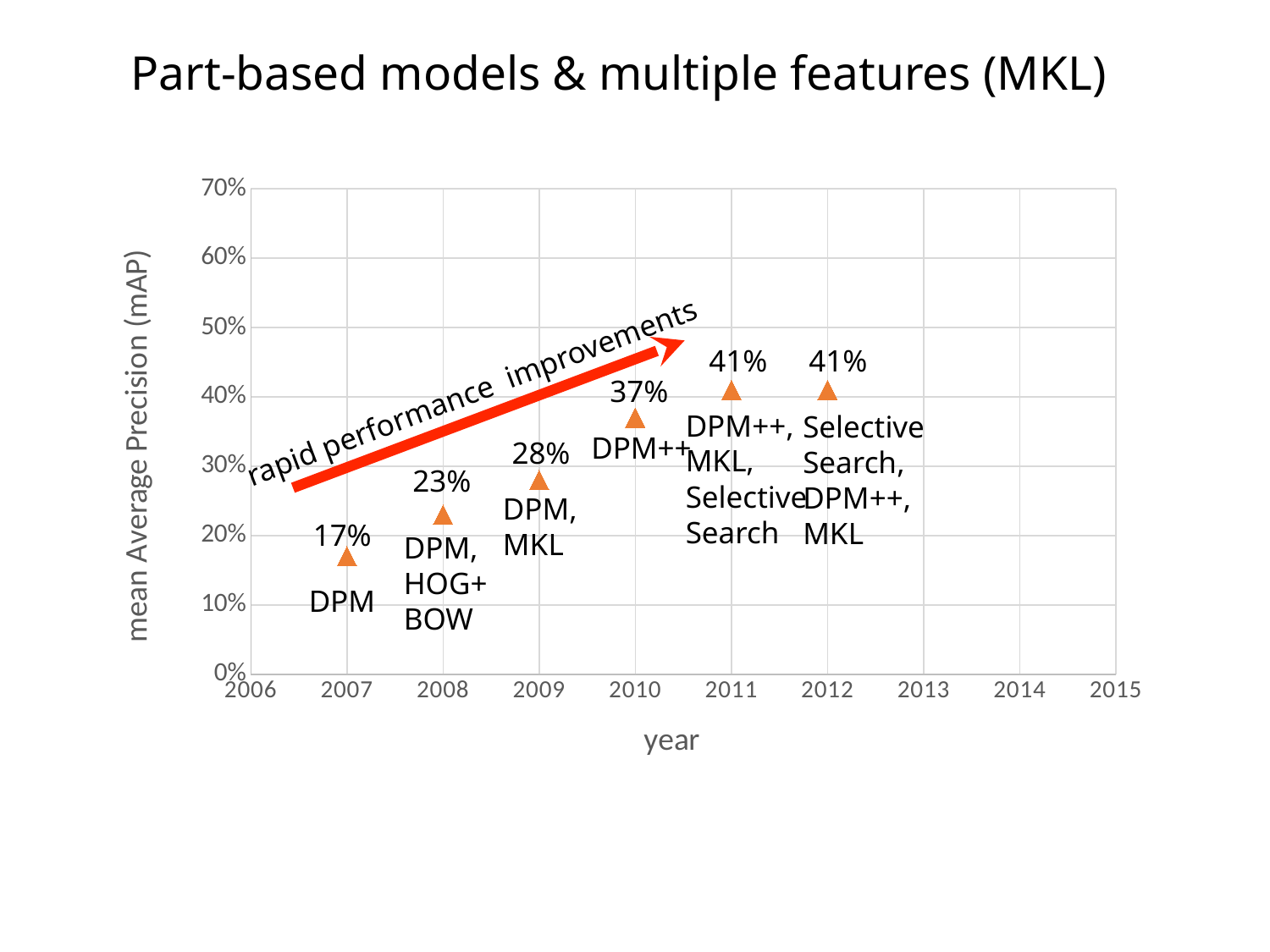
Which year has the lowest plotted mAP value? 2007 What is the mAP value plotted for 2012? 41% How many data points are plotted on the chart? 6 What is the mean Average Precision (mAP) value plotted for 2007? 17% What is the difference in mAP between 2011 and 2007? 24% What is the difference in mAP between 2010 and 2008? 14% What is the mAP value plotted for 2009? 28% What is the mAP value plotted for 2010? 37% Which is larger, the mAP value for 2009 or for 2010? 2010 Do the plotted mAP values rise or fall from 2007 to 2012? rise Is the mAP value for 2008 greater or less than 30%? less What is the label on the x axis of the chart? year